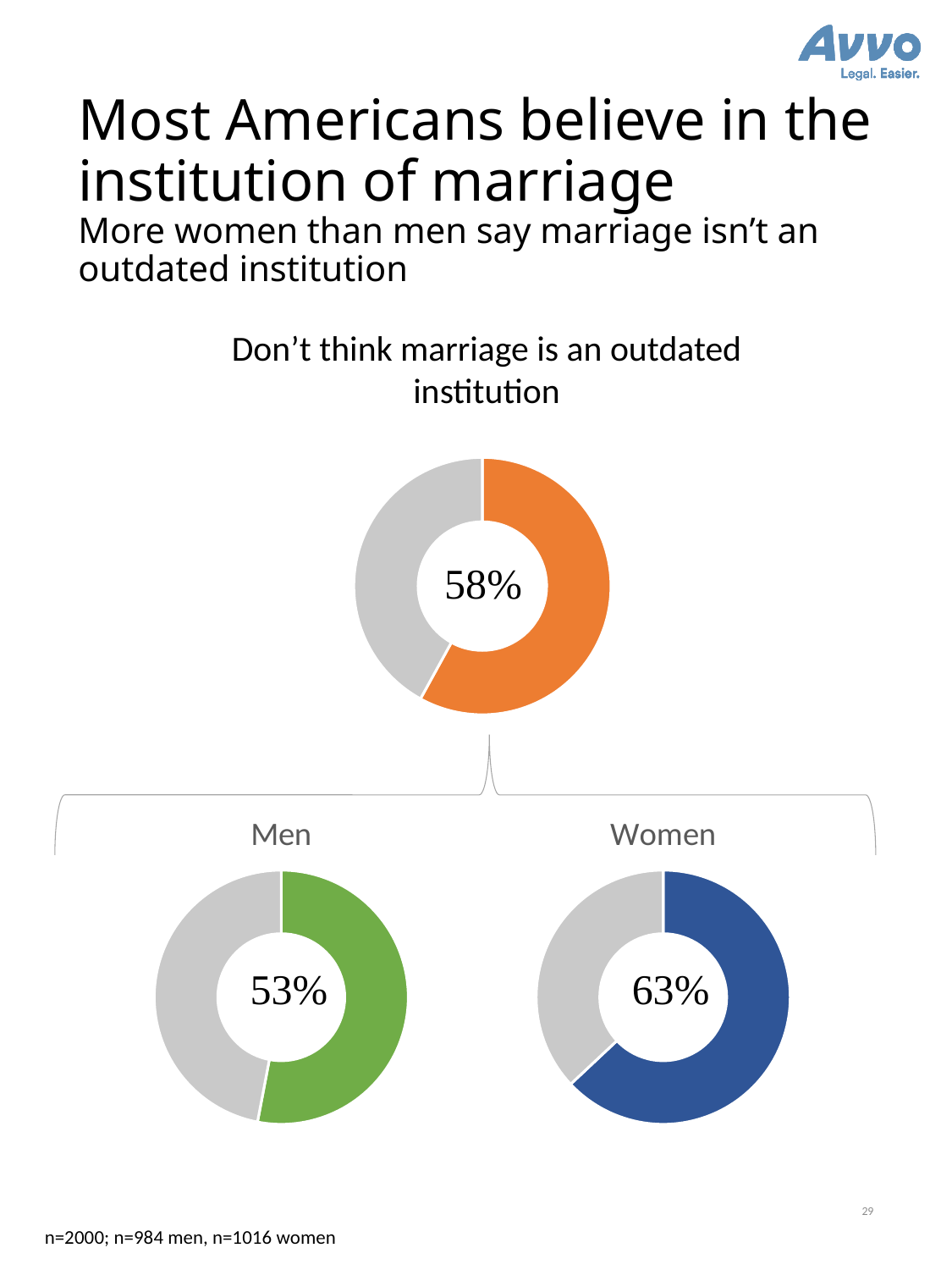
In the top chart, is the value shown greater or less than 50%? greater How many doughnut charts are shown on the slide? 3 What colour is the highlighted segment in the 'Women' chart? Blue In the bottom-right chart labelled 'Women', what percentage is shown? 63% Of the three charts on the slide, which one shows the lowest percentage? Men In the bottom-left chart labelled 'Men', what percentage is shown? 53% Of the three charts on the slide, which one shows the highest percentage? Women What is the difference between the percentage shown in the 'Women' chart and the percentage shown in the 'Men' chart? 10% What kind of chart is used for the 'Men' and 'Women' figures on the slide? Doughnut (pie) chart Comparing the 'Men' and 'Women' charts, which group has the higher percentage who don't think marriage is an outdated institution? Women In the top chart titled 'Don't think marriage is an outdated institution', what percentage is shown in the centre? 58% What is the title of the top chart on the slide? Don't think marriage is an outdated institution